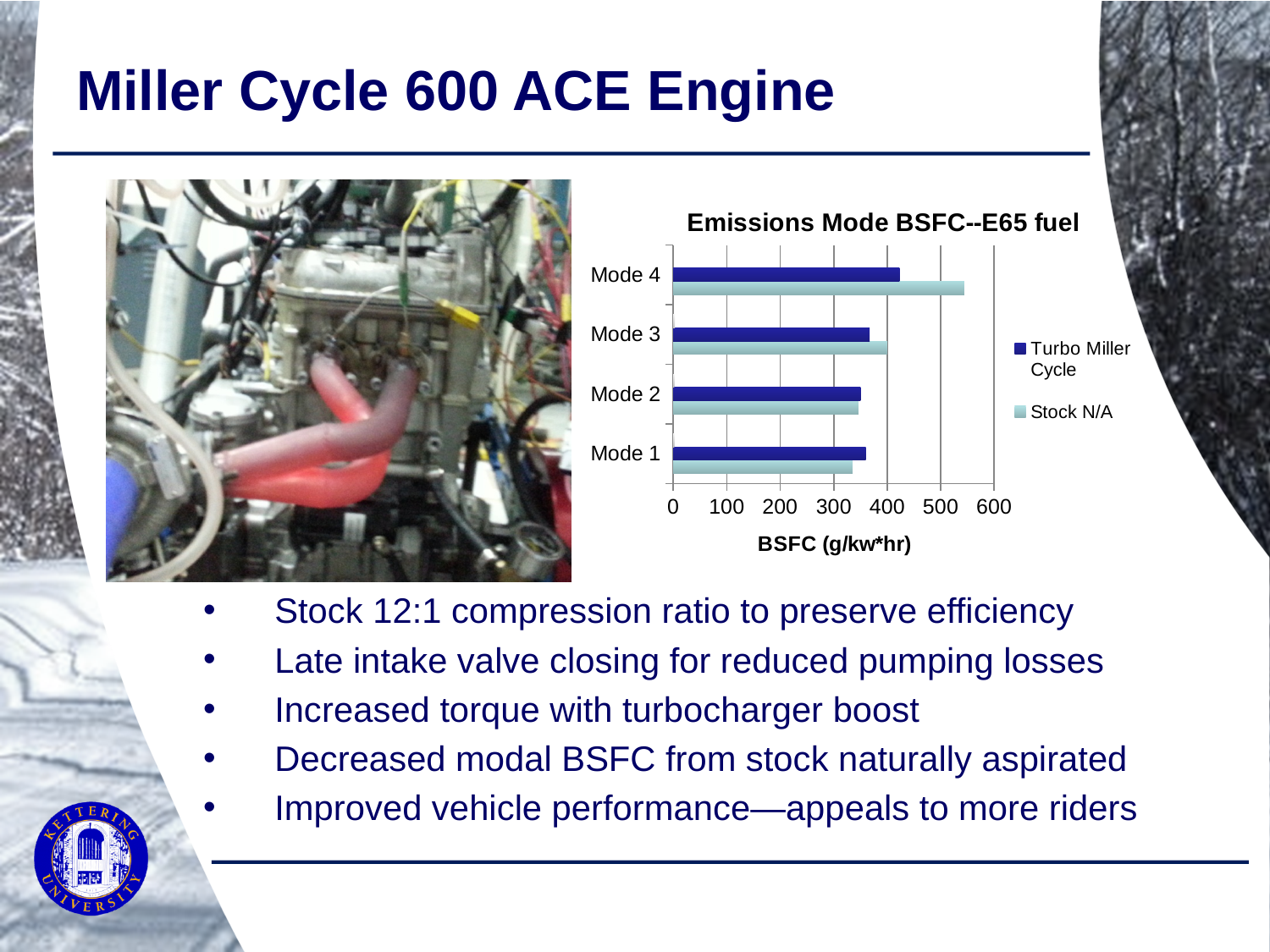
How many emission modes (categories) are plotted in the chart? 4 What is the title of the chart? Emissions Mode BSFC--E65 fuel How many series does the chart's legend list? 2 For Mode 4, which series has the larger BSFC value, Turbo Miller Cycle or Stock N/A? Stock N/A What kind of chart is shown on the slide? bar chart Is the Turbo Miller Cycle value for Mode 4 greater or less than 400? greater What is the label of the horizontal axis of the chart? BSFC (g/kw*hr) Which mode has the highest Turbo Miller Cycle BSFC value? Mode 4 Is the Stock N/A value for Mode 4 greater or less than 500? greater For Mode 3, which series has the larger BSFC value, Turbo Miller Cycle or Stock N/A? Stock N/A Which mode has the highest Stock N/A BSFC value? Mode 4 Is the Turbo Miller Cycle value for Mode 3 greater or less than 400? less